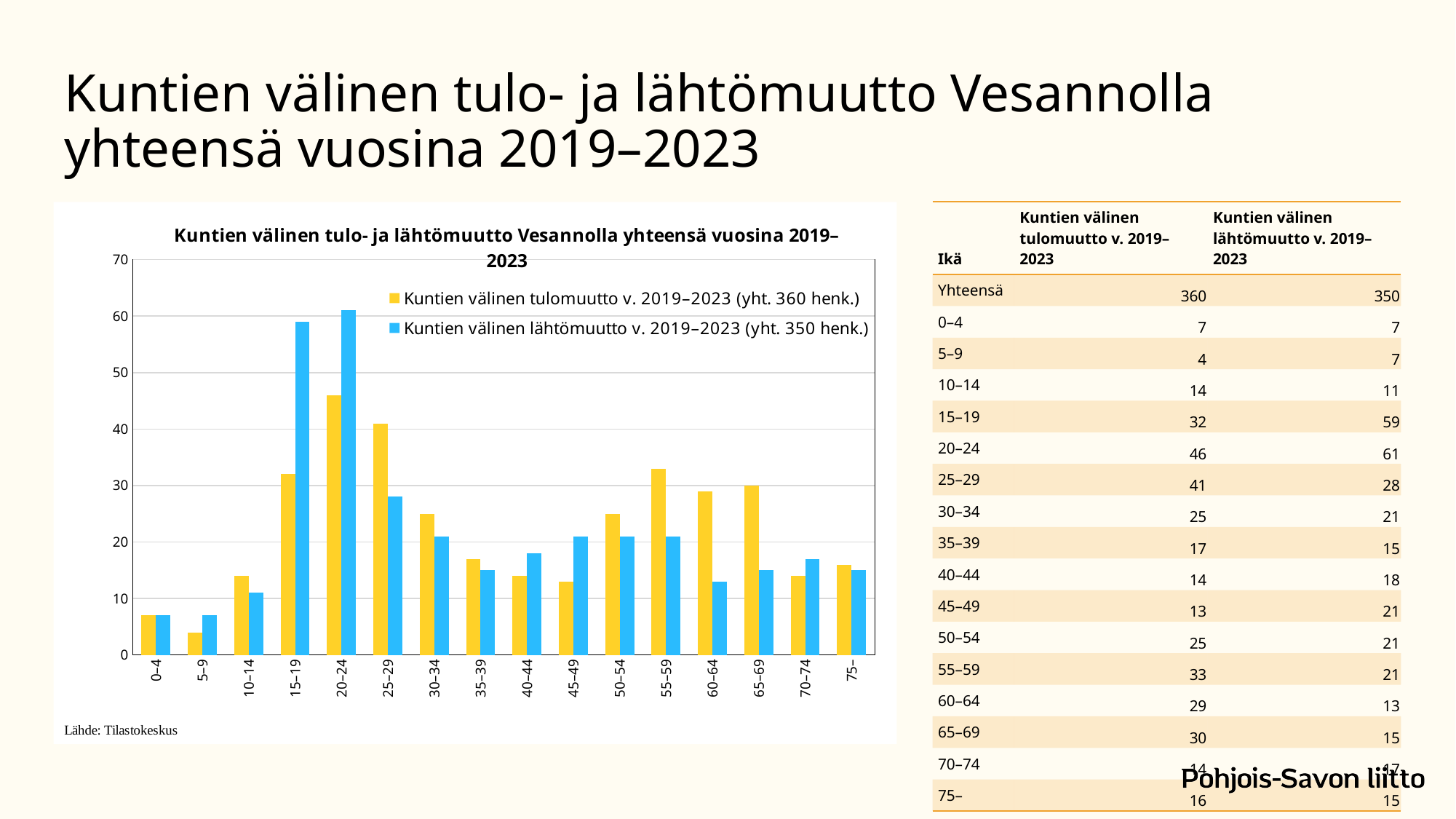
Which age group has the lowest value for Kuntien välinen tulomuutto v. 2019–2023? 5–9 How many age groups are shown on the x axis of the chart? 16 For the 60–64 age group, which is larger: tulomuutto or lähtömuutto? tulomuutto What is the difference between lähtömuutto and tulomuutto for the 20–24 age group? 15 How many series does the chart legend list? 2 What is the value of Kuntien välinen tulomuutto v. 2019–2023 for the 20–24 age group? 46 According to the legend, what is the total number of people for Kuntien välinen tulomuutto v. 2019–2023? 360 henk. Is the value of Kuntien välinen lähtömuutto for the 15–19 age group greater or less than 50? greater Which age group has the highest value for Kuntien välinen lähtömuutto v. 2019–2023? 20–24 Which colour represents Kuntien välinen lähtömuutto v. 2019–2023 in the chart? blue What kind of chart is shown on the slide? bar chart What is the value of Kuntien välinen lähtömuutto v. 2019–2023 for the 15–19 age group? 59